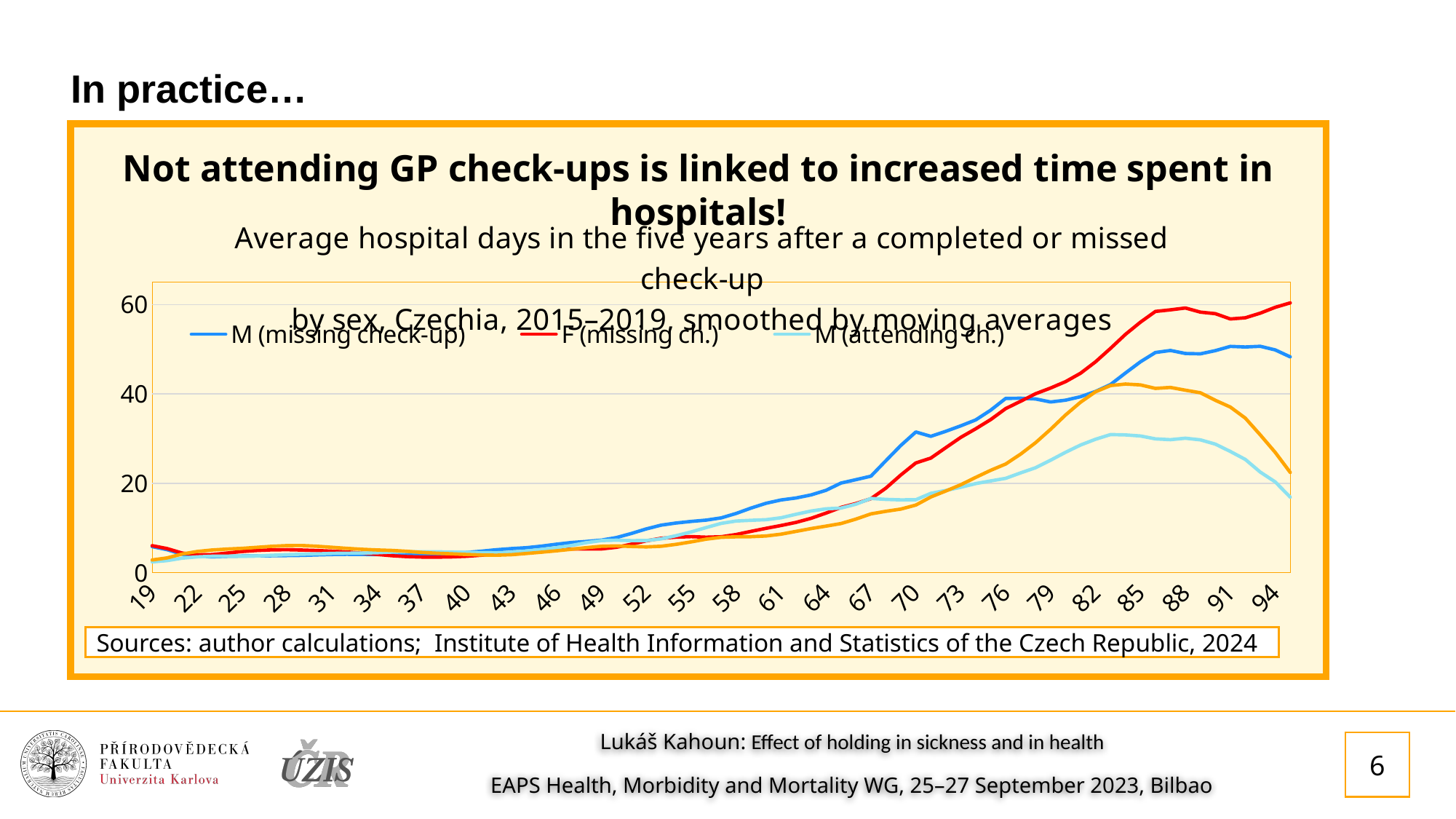
Is the value for M (missing check-up) at age 94 greater or less than 40? greater At age 85, which is higher: M (missing check-up) or M (attending ch.)? M (missing check-up) What is the highest value shown on the vertical axis? 60 Is the value for M (attending ch.) at age 70 greater or less than 20? less What is the first age shown on the horizontal axis? 19 At age 94, which is higher: F (missing ch.) or M (missing check-up)? F (missing ch.) Which series reaches the highest value on the chart? F (missing ch.) Is the value for M (attending ch.) at age 85 greater or less than 40? less What kind of chart is shown on the slide? line chart Do the values for M (missing check-up) generally rise or fall from age 19 to age 85? rise